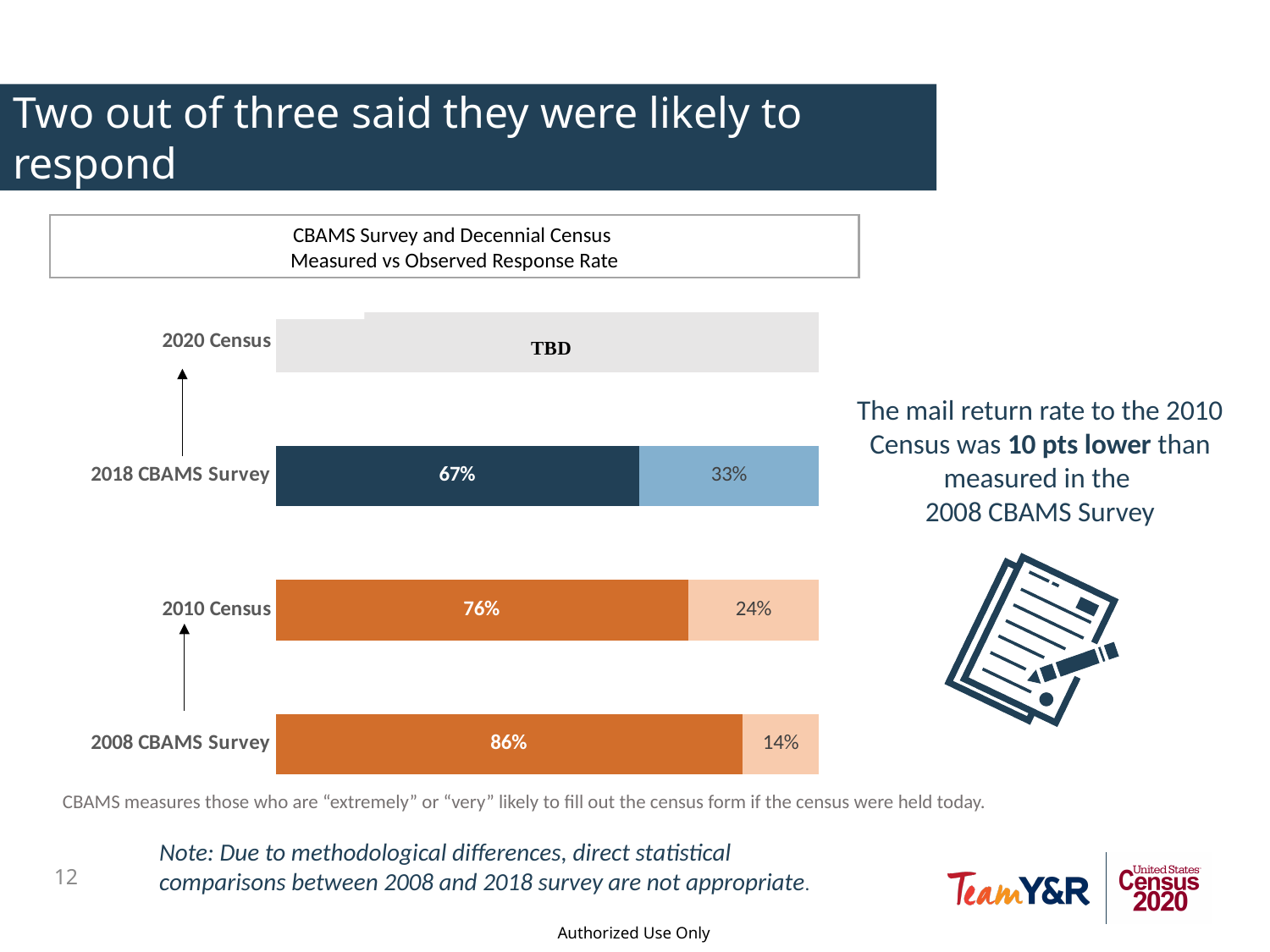
Which category has the highest first-segment value among the bars with printed values? 2008 CBAMS Survey What is the title of the chart? CBAMS Survey and Decennial Census Measured vs Observed Response Rate What is the smaller segment value for the 2018 CBAMS Survey bar? 33% What type of chart is shown on the slide? Stacked bar chart What label is shown on the 2020 Census bar? TBD Which is larger: the first-segment value for the 2010 Census or for the 2018 CBAMS Survey? 2010 Census What is the difference between the first-segment values of the 2008 CBAMS Survey and the 2010 Census? 10 percentage points Which category has the lowest first-segment value among the bars with printed values? 2018 CBAMS Survey What is the larger segment value for the 2018 CBAMS Survey bar? 67% What is the smaller segment value for the 2008 CBAMS Survey bar? 14% What is the larger segment value for the 2010 Census bar? 76% How many categories are shown on the chart? 4